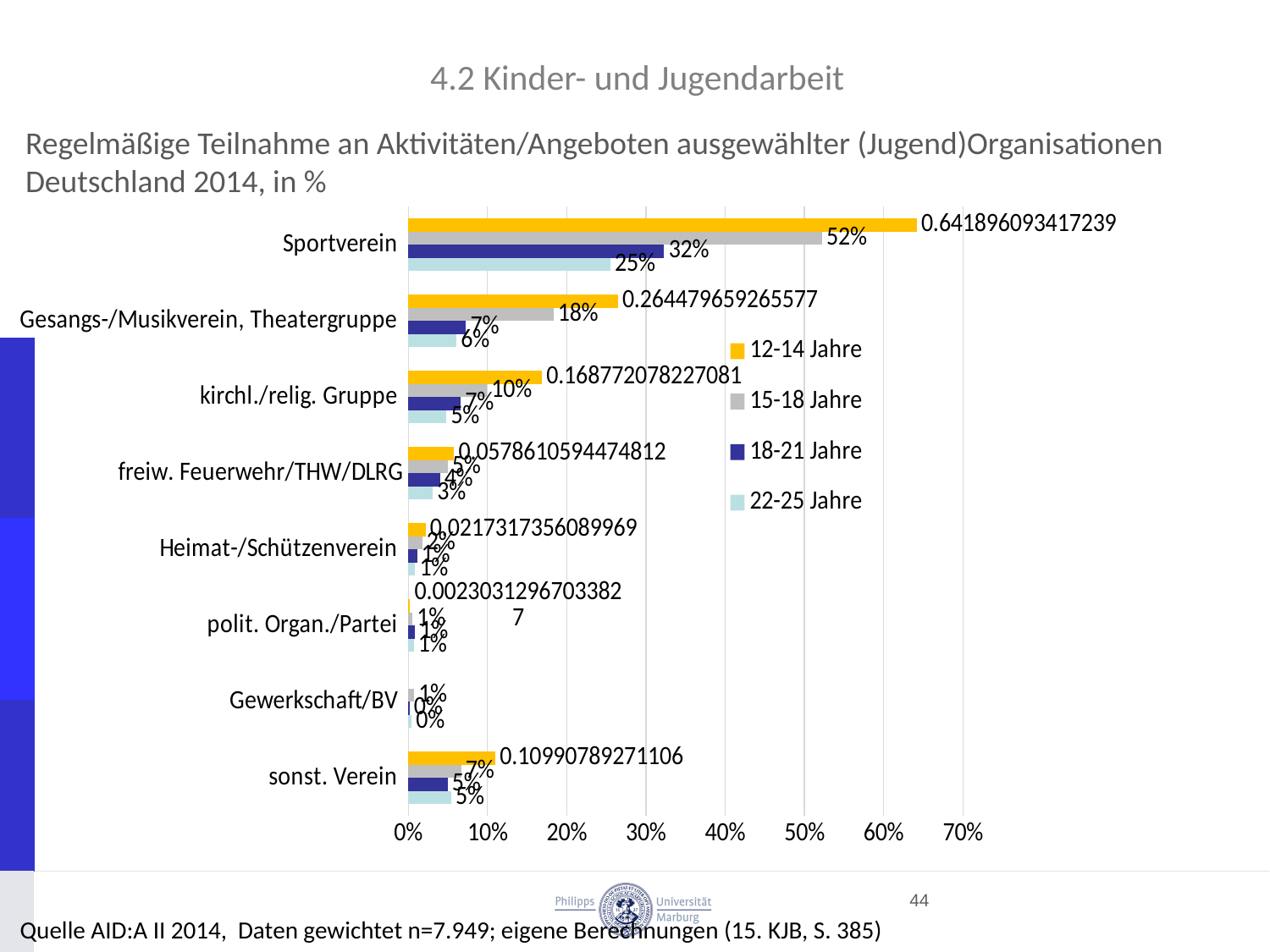
Which colour represents the 12-14 Jahre series in the legend? yellow Which category has the highest value for the 15-18 Jahre series? Sportverein Which age group has the highest value in the Sportverein category? 12-14 Jahre What is the value for 18-21 Jahre in the Sportverein category? 32% How many series does the legend list? 4 What kind of chart is shown on the slide? bar chart Is the value for 12-14 Jahre in the Sportverein category greater or less than 60%? greater What is the value for 22-25 Jahre in the Sportverein category? 25% What is the value for 15-18 Jahre in the Gesangs-/Musikverein, Theatergruppe category? 18% How many organisation categories are plotted on the chart? 8 What is the value for 15-18 Jahre in the Sportverein category? 52% What is the difference between the 15-18 Jahre and 18-21 Jahre values for Sportverein? 20 percentage points